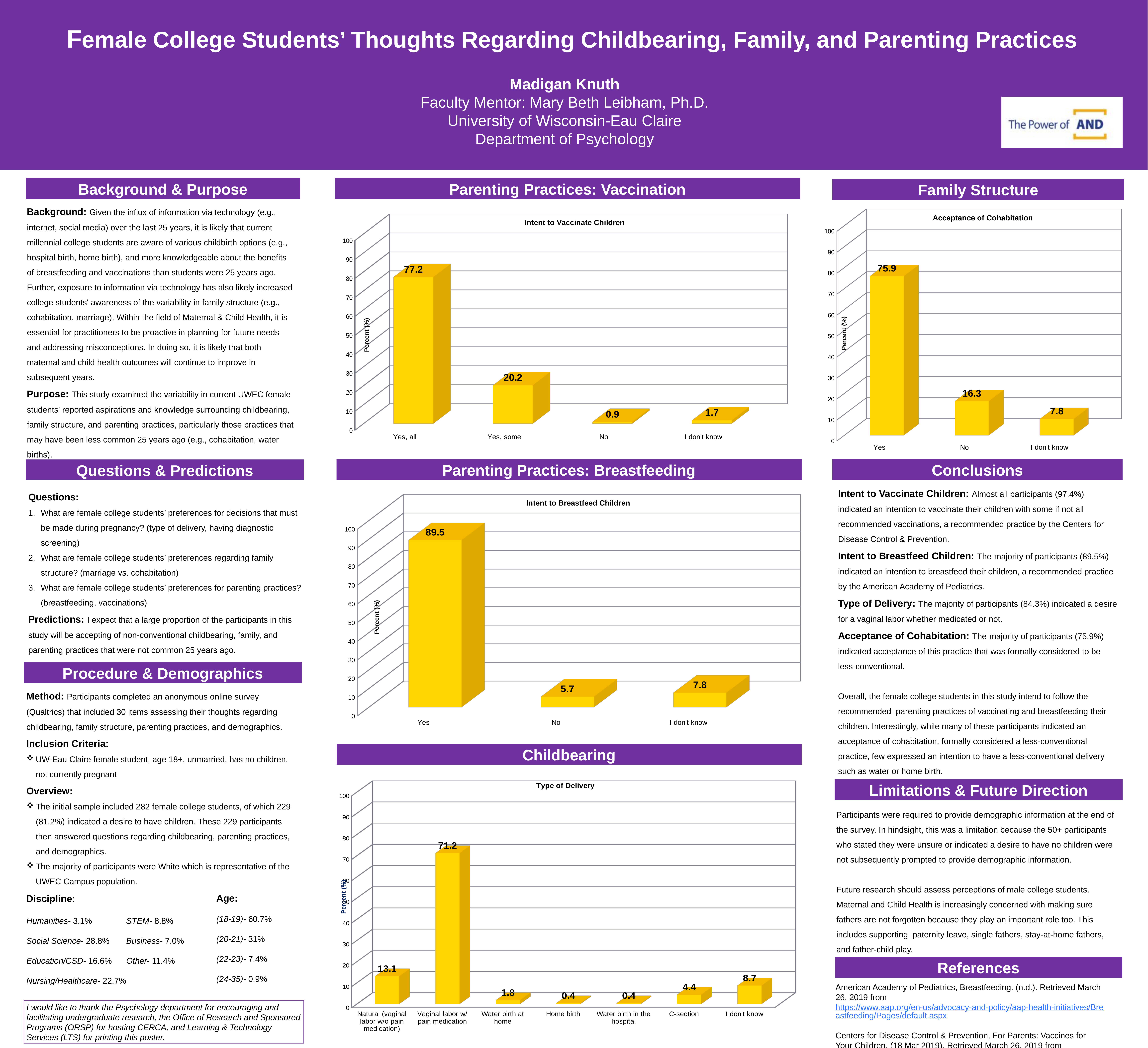
In the 'Acceptance of Cohabitation' chart, how many categories are shown on the x axis? 3 In the 'Type of Delivery' chart, what is the value for 'C-section'? 4.4 In the 'Intent to Vaccinate Children' chart, which category has the lowest value? No In the 'Type of Delivery' chart, which category has the highest value? Vaginal labor w/ pain medication In the 'Acceptance of Cohabitation' chart, what is the value for 'No'? 16.3 In the 'Intent to Breastfeed Children' chart, what is the difference between 'I don't know' and 'No'? 2.1 In the 'Acceptance of Cohabitation' chart, which is larger, 'No' or 'I don't know'? No What kind of chart is the 'Type of Delivery' chart? Bar chart In the 'Intent to Vaccinate Children' chart, what is the difference between 'Yes, all' and 'Yes, some'? 57.0 In the 'Intent to Breastfeed Children' chart, what is the value for 'Yes'? 89.5 In the 'Type of Delivery' chart, how many categories are shown on the x axis? 7 In the 'Intent to Vaccinate Children' chart, what is the value for 'Yes, all'? 77.2